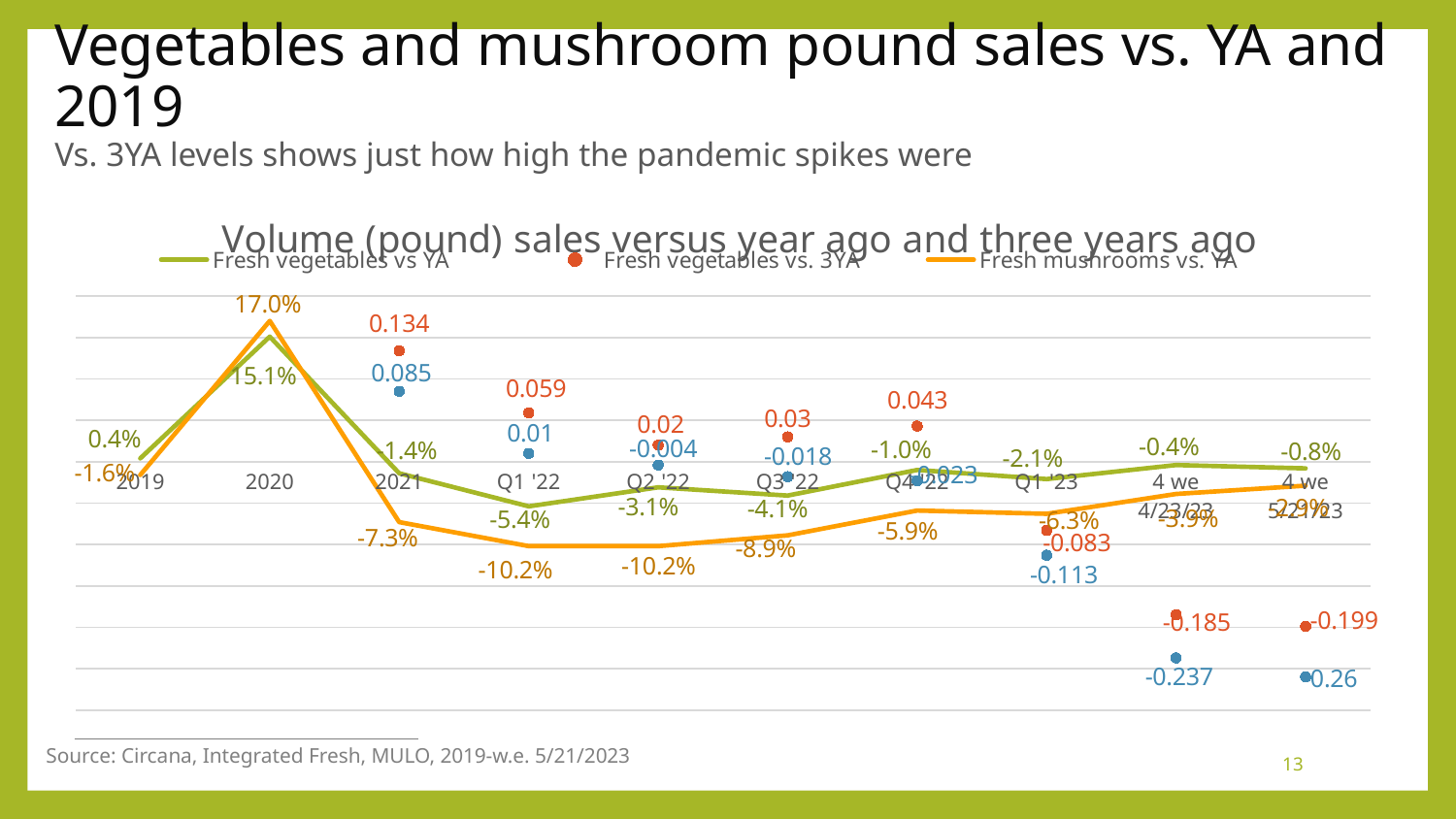
In which period is the Fresh mushrooms vs. YA value highest? 2020 In which period is the Fresh vegetables vs YA value lowest? Q1 '22 What is the value for Fresh mushrooms vs. YA in 2020? 17.0% Do the Fresh vegetables vs. 3YA values rise or fall from Q4 '22 to the 4 weeks ending 5/21/23? Fall What kind of chart is shown on the slide? Line chart What is the value for Fresh mushrooms vs. YA in Q3 '22? -8.9% What is the difference between the Fresh mushrooms vs. YA and Fresh vegetables vs YA values in 2020? 1.9 percentage points What is the value for Fresh vegetables vs YA in 2020? 15.1% In Q4 '22, which is larger: Fresh vegetables vs YA or Fresh mushrooms vs. YA? Fresh vegetables vs YA What is the value for Fresh vegetables vs. 3YA for the 4 weeks ending 5/21/23? -0.199 What is the value for Fresh vegetables vs. 3YA in 2021? 0.134 What is the title of the chart? Volume (pound) sales versus year ago and three years ago